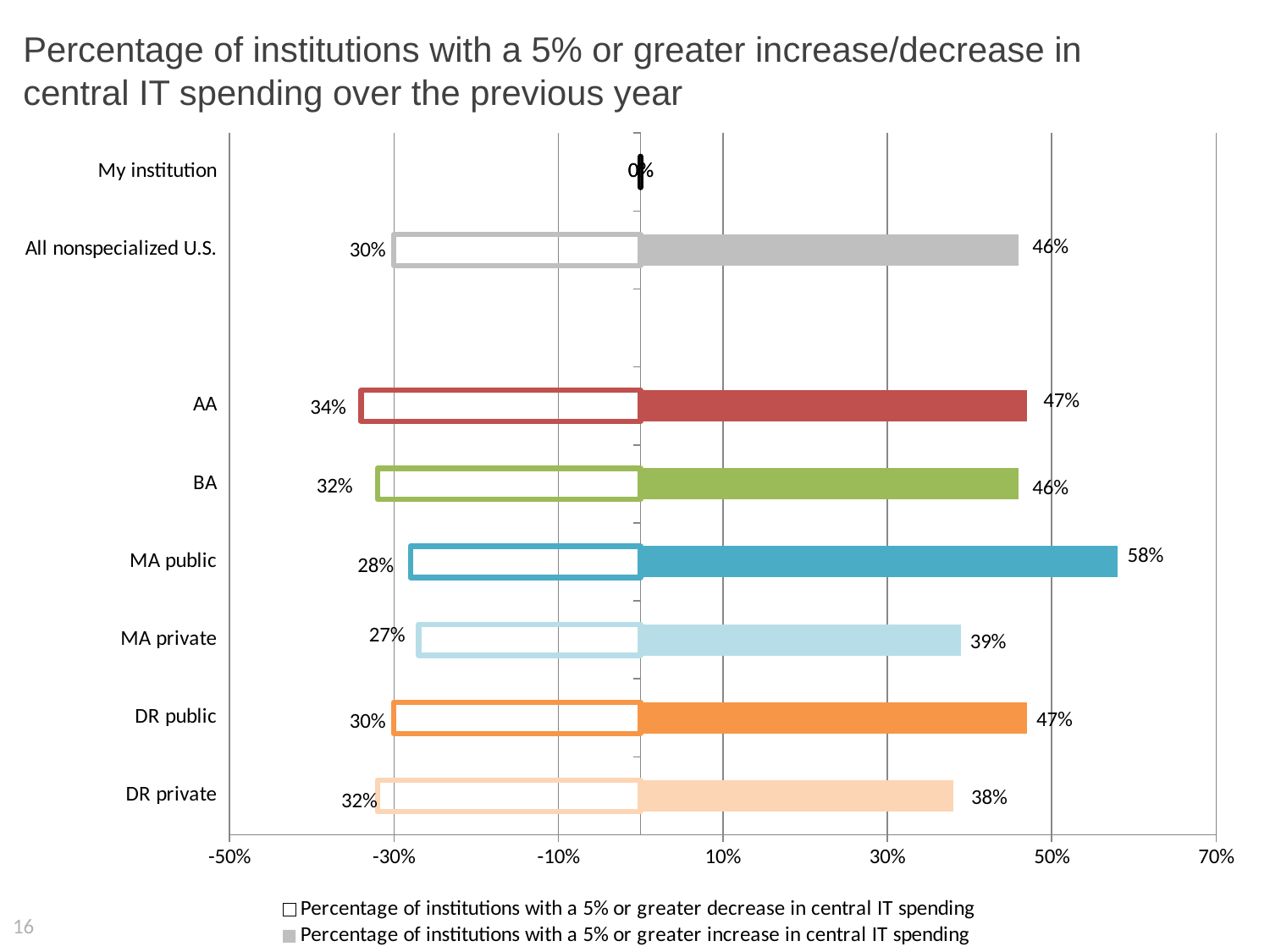
What percentage of MA public institutions had a 5% or greater increase in central IT spending? 58% How many series does the legend list? 2 Which is larger: the percentage of DR public institutions with a 5% or greater increase or the percentage of DR private institutions with a 5% or greater increase? DR public What percentage of AA institutions had a 5% or greater decrease in central IT spending? 34% Which institution type has the highest percentage with a 5% or greater increase in central IT spending? MA public What kind of chart is shown on the slide? Bar chart What value is shown for My institution? 0% Which institution type has the lowest percentage with a 5% or greater decrease in central IT spending? MA private What is the value shown for All nonspecialized U.S. institutions with a 5% or greater increase in central IT spending? 46% What is the difference between the percentage of MA public institutions with a 5% or greater increase and the percentage of MA private institutions with a 5% or greater increase? 19% Which institution type has the lowest percentage with a 5% or greater increase in central IT spending? DR private How many institution categories are shown on the chart? 8